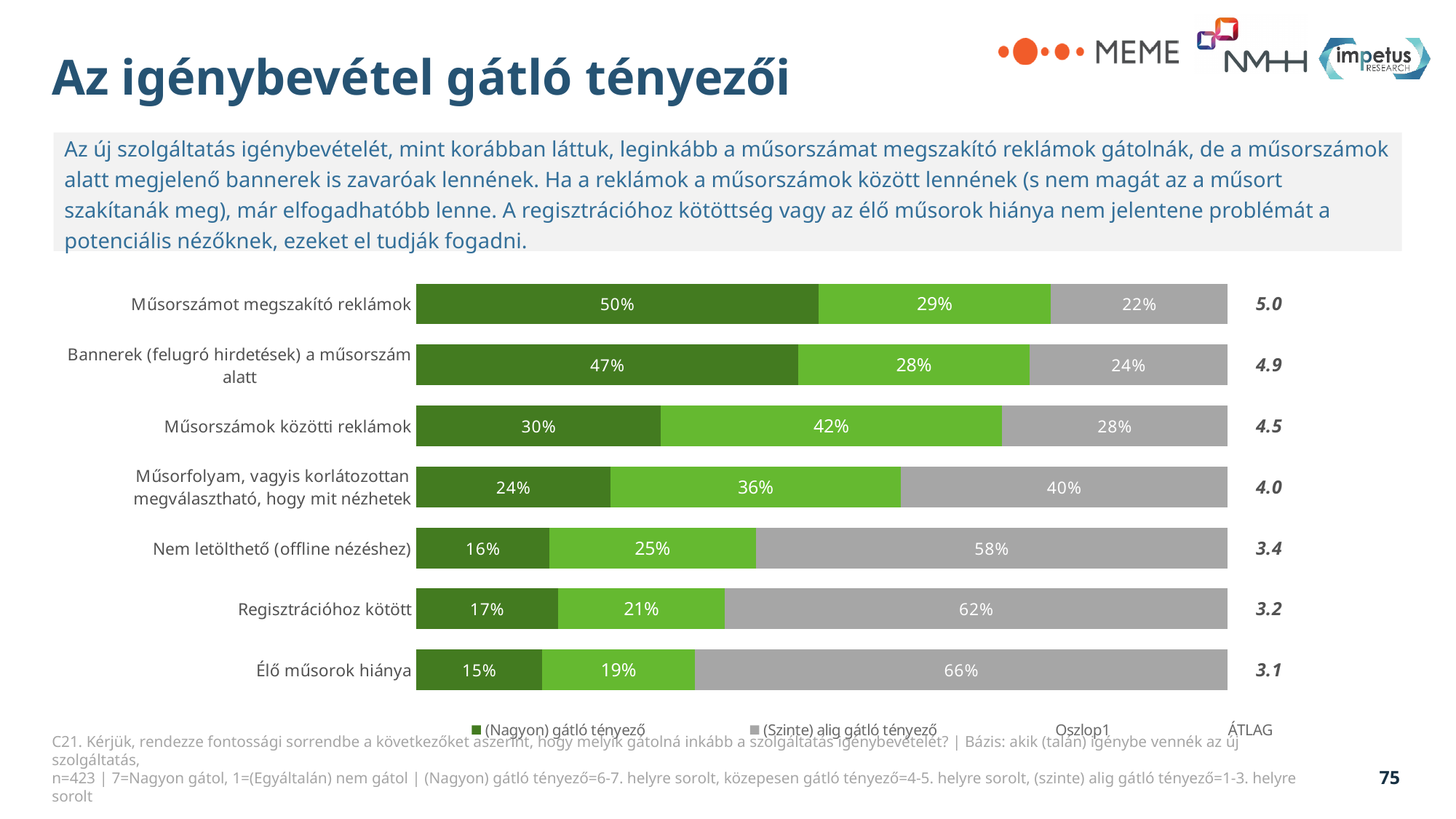
What is the ÁTLAG value shown for 'Bannerek (felugró hirdetések) a műsorszám alatt'? 4.9 How many categories are shown in the chart? 7 Which colour represents the (Szinte) alig gátló tényező series in the chart? Grey What percentage of respondents rated 'Műsorszámot megszakító reklámok' as a (Nagyon) gátló tényező? 50% What is the difference between the (Szinte) alig gátló tényező shares for 'Regisztrációhoz kötött' and 'Nem letölthető (offline nézéshez)'? 4% Which category has the highest ÁTLAG value? Műsorszámot megszakító reklámok What is the ÁTLAG value for 'Nem letölthető (offline nézéshez)'? 3.4 What percentage of respondents rated 'Élő műsorok hiánya' as a (Szinte) alig gátló tényező? 66% What is the difference between the ÁTLAG values of 'Műsorszámot megszakító reklámok' and 'Élő műsorok hiánya'? 1.9 Which category has the lowest share of (Nagyon) gátló tényező responses? Élő műsorok hiánya Which has a larger (Nagyon) gátló tényező share: 'Műsorszámok közötti reklámok' or 'Műsorfolyam, vagyis korlátozottan megválasztható, hogy mit nézhetek'? Műsorszámok közötti reklámok What kind of chart is shown on the slide? Stacked bar chart